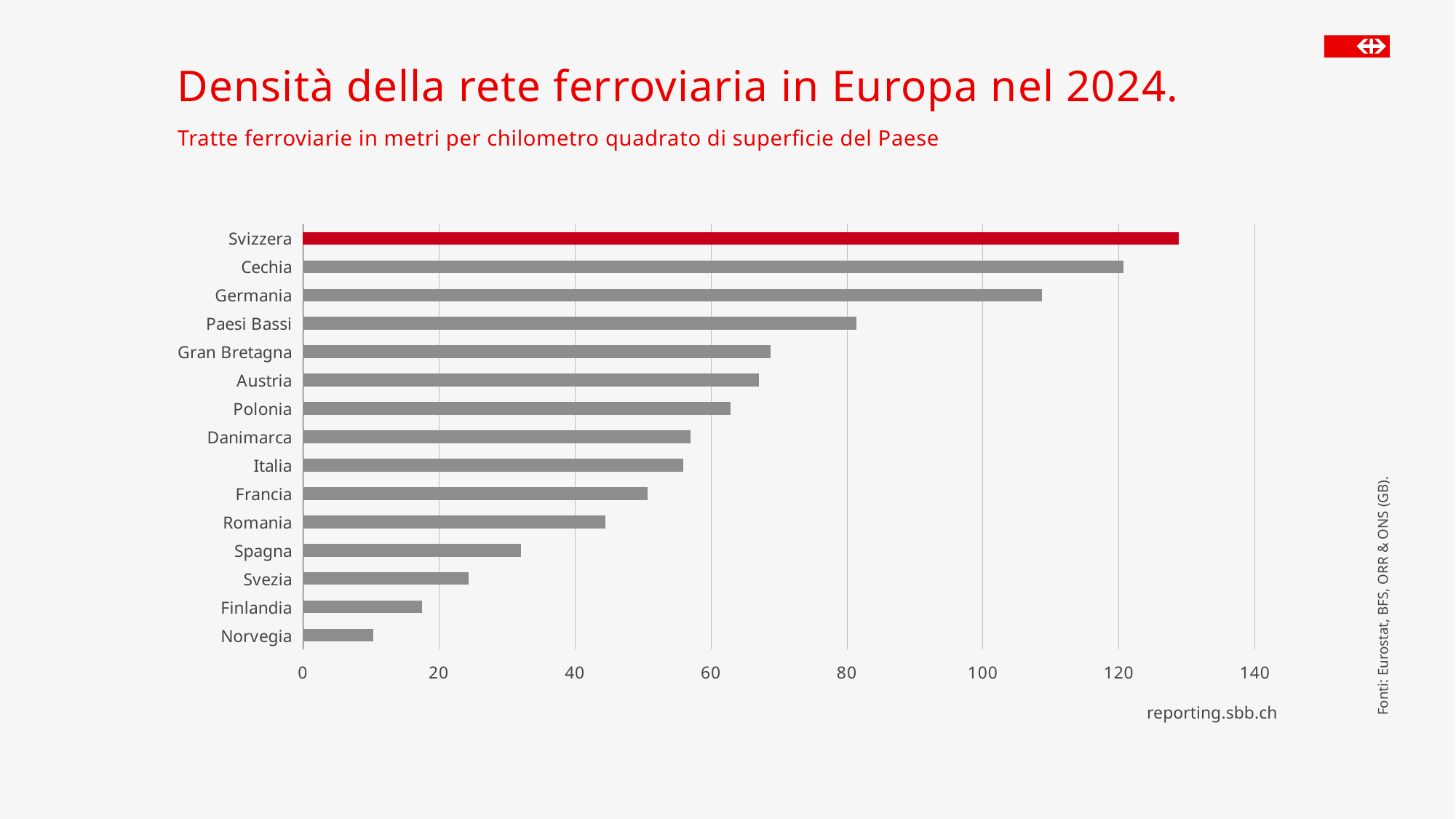
Which country has the lowest railway network density in the chart? Norvegia Which has the larger value, Cechia or Germania? Cechia Which has the larger value, Spagna or Svezia? Spagna Is the value for Paesi Bassi greater or less than 100? less Which country's bar is highlighted in red? Svizzera What kind of chart is shown on the slide? bar chart Is the value for Germania greater or less than 100? greater Is the value for Norvegia greater or less than 20? less How many countries are shown in the chart? 15 Which country has the highest railway network density in the chart? Svizzera